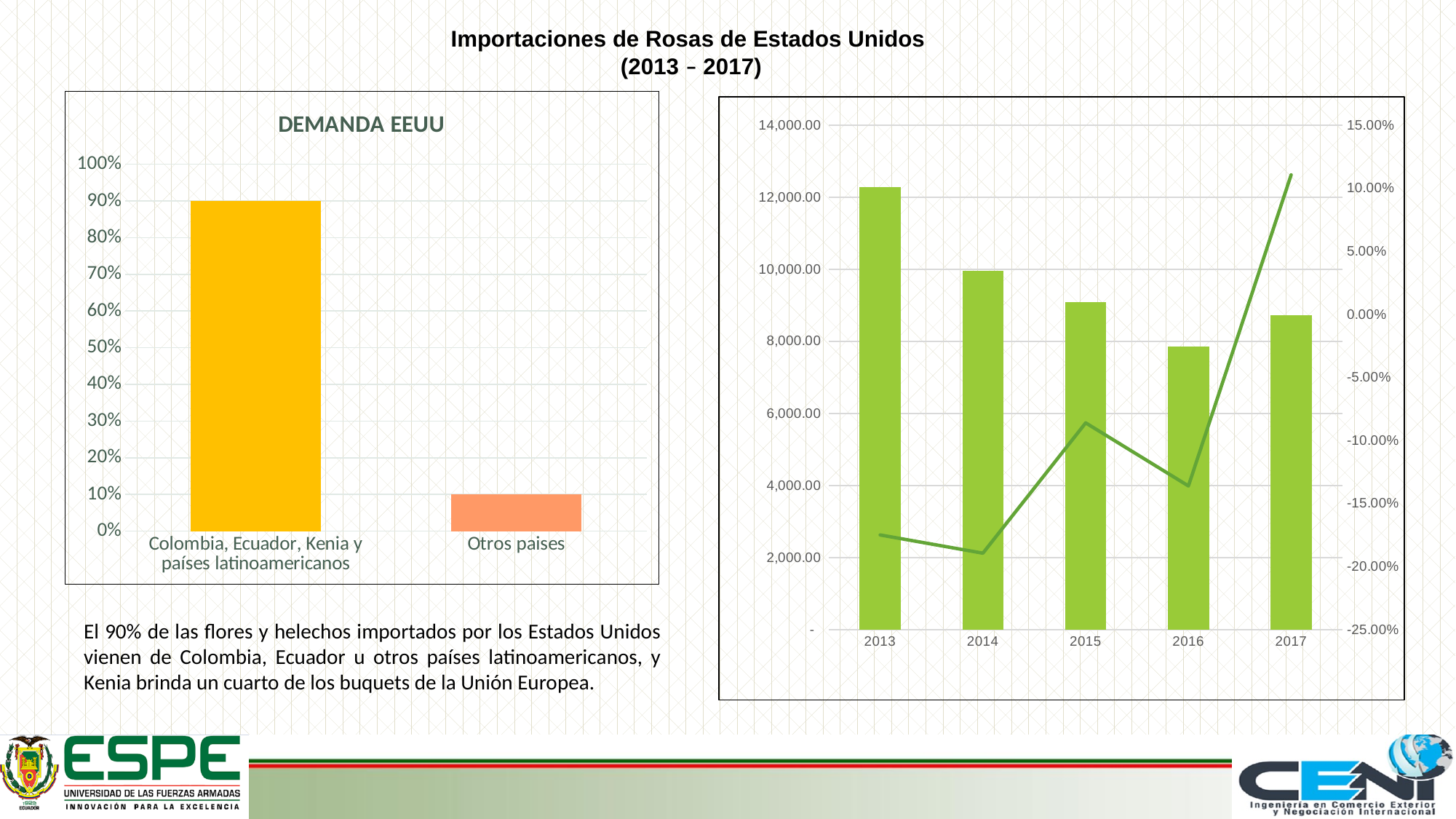
In the chart on the right, which year has the shortest bar? 2016 What kind of chart is the DEMANDA EEUU chart? Bar chart In the chart on the right, how many years are shown on the x axis? 5 In the DEMANDA EEUU chart, what is the value for Colombia, Ecuador, Kenia y países latinoamericanos? 90% In the chart on the right, is the bar for 2013 greater or less than 12,000.00? greater In the chart on the right, do the bars rise or fall from 2013 to 2016? fall In the chart on the right, which year has the tallest bar? 2013 In the DEMANDA EEUU chart, what is the difference between the two bars? 80% In the DEMANDA EEUU chart, what is the value for Otros paises? 10% In the DEMANDA EEUU chart, how many categories are shown? 2 In the chart on the right, is the bar for 2016 greater or less than 8,000.00? less In the chart on the right, in which year does the line reach its highest point? 2017